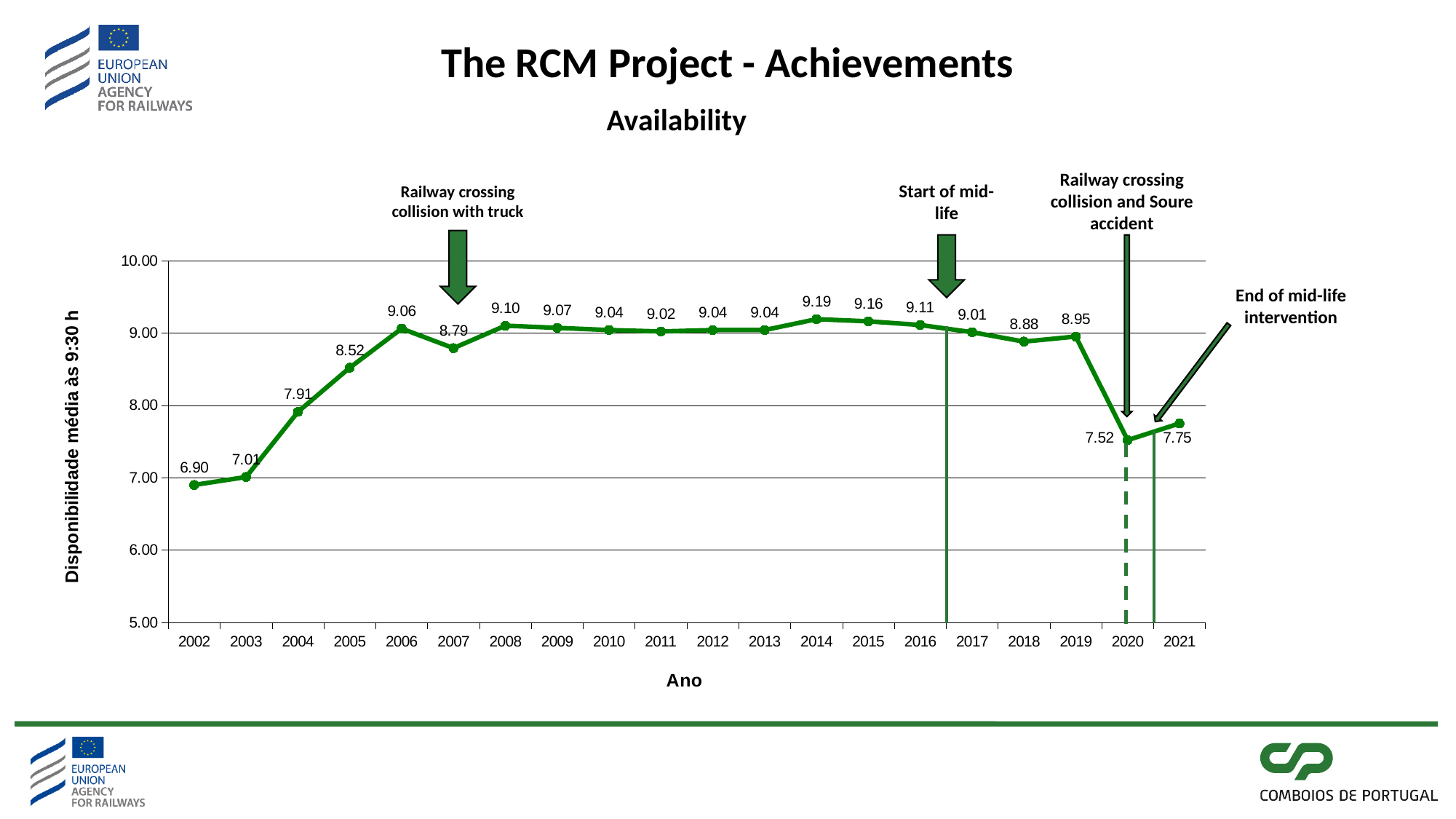
How many years are plotted on the x axis? 20 What is the availability value for 2014? 9.19 Which year has the highest availability value? 2014 What is the availability value for 2007? 8.79 What is the difference between the availability values for 2014 and 2002? 2.29 What kind of chart is shown on the slide? line chart Which year has the larger availability value, 2006 or 2007? 2006 Do the availability values rise or fall from 2002 to 2006? rise Which year has the lowest availability value? 2002 Is the value for 2005 greater or less than 8.00? greater What is the difference between the availability values for 2019 and 2020? 1.43 What is the availability value for 2020? 7.52